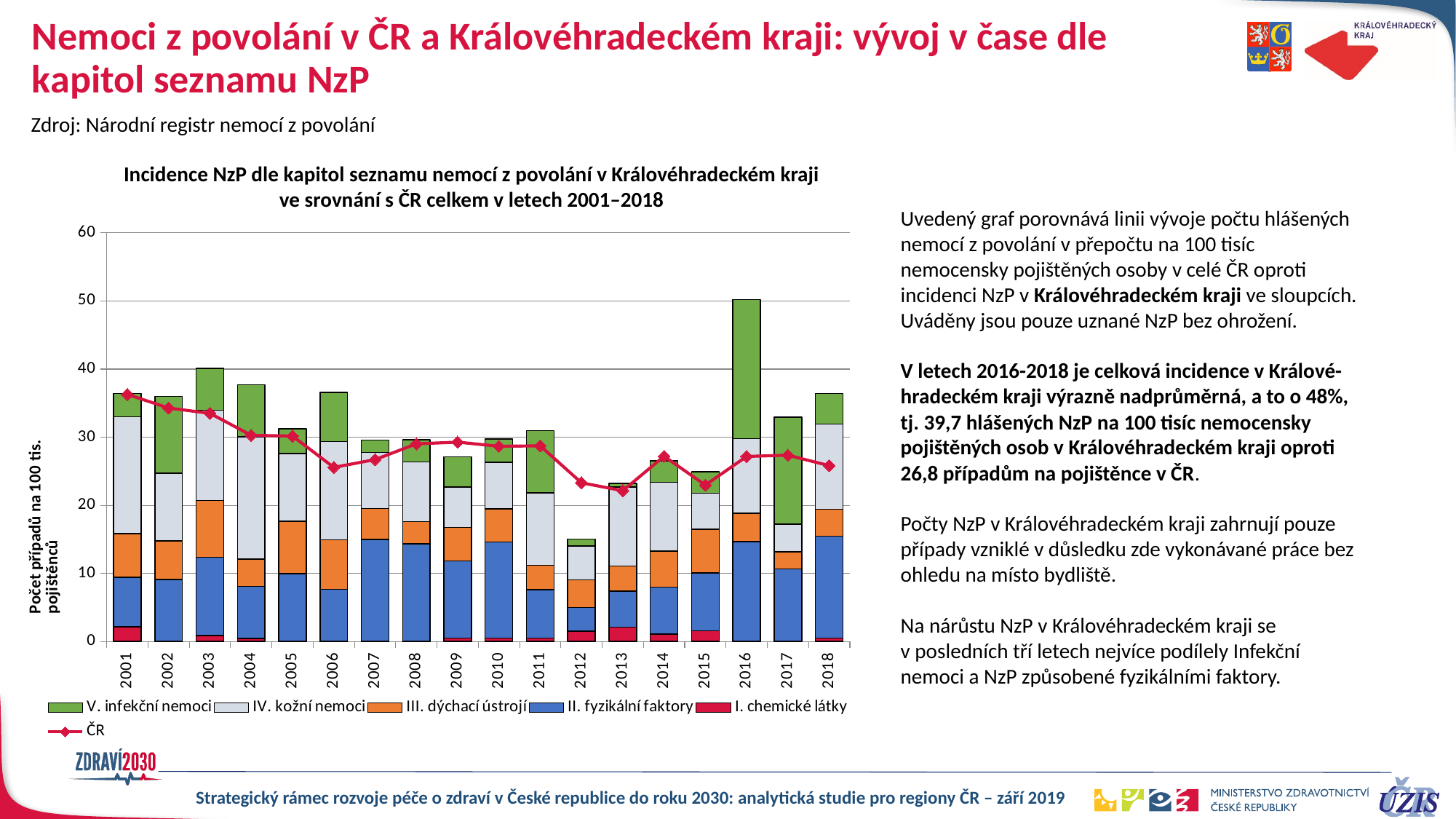
Does the ČR line rise or fall from 2001 to 2006? fall Is the total stacked bar value for 2012 greater or less than 20? less How many series does the chart legend list? 6 Which year has the larger total stacked bar, 2016 or 2017? 2016 What colour represents the series 'V. infekční nemoci' in the chart? Green Which year has the shortest stacked bar? 2012 Which series is plotted as a line rather than as stacked bars? ČR What kind of chart is shown on the slide? Stacked bar chart with a line How many years are shown on the x axis of the chart? 18 Which year has the tallest stacked bar? 2016 Is the total stacked bar value for 2016 greater or less than 40? greater Is the ČR line value for 2013 greater or less than 30? less